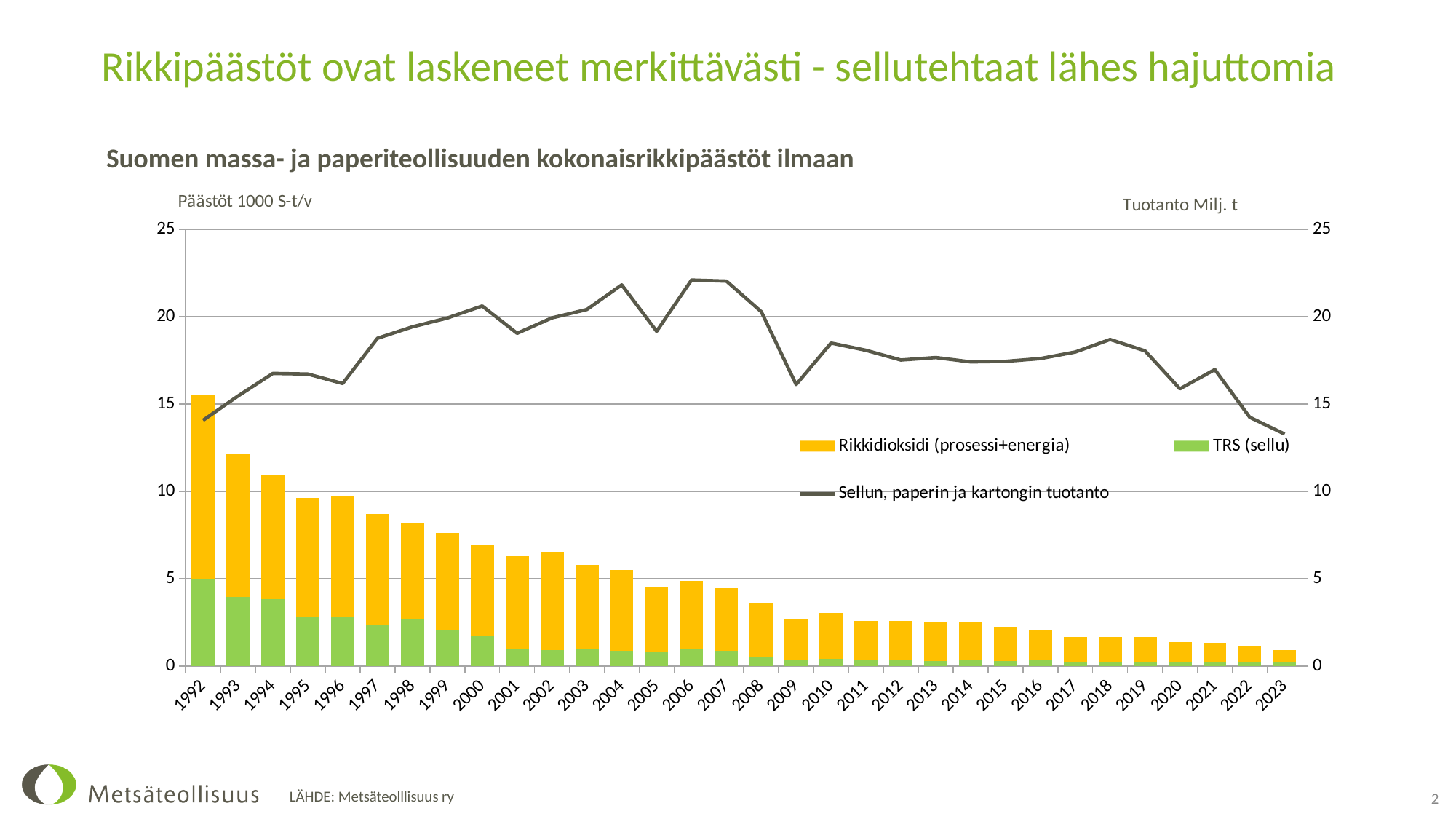
How many series does the chart legend list? 3 What kind of chart is used to show the emissions (Rikkidioksidi and TRS) on this slide? Stacked bar chart Which year has the larger total emissions bar, 1992 or 2023? 1992 How many years are shown on the x axis of the chart? 32 Is the total emissions bar for 1992 greater or less than 15? greater Do the total sulphur emissions bars rise or fall from 1992 to 2023? fall Is the production line value (Sellun, paperin ja kartongin tuotanto) for 2006 greater or less than 20? greater Which year has the highest total sulphur emissions bar? 1992 Is the total emissions bar for 2023 greater or less than 5? less Which year has the lowest total sulphur emissions bar? 2023 What is the title of the chart? Suomen massa- ja paperiteollisuuden kokonaisrikkipäästöt ilmaan